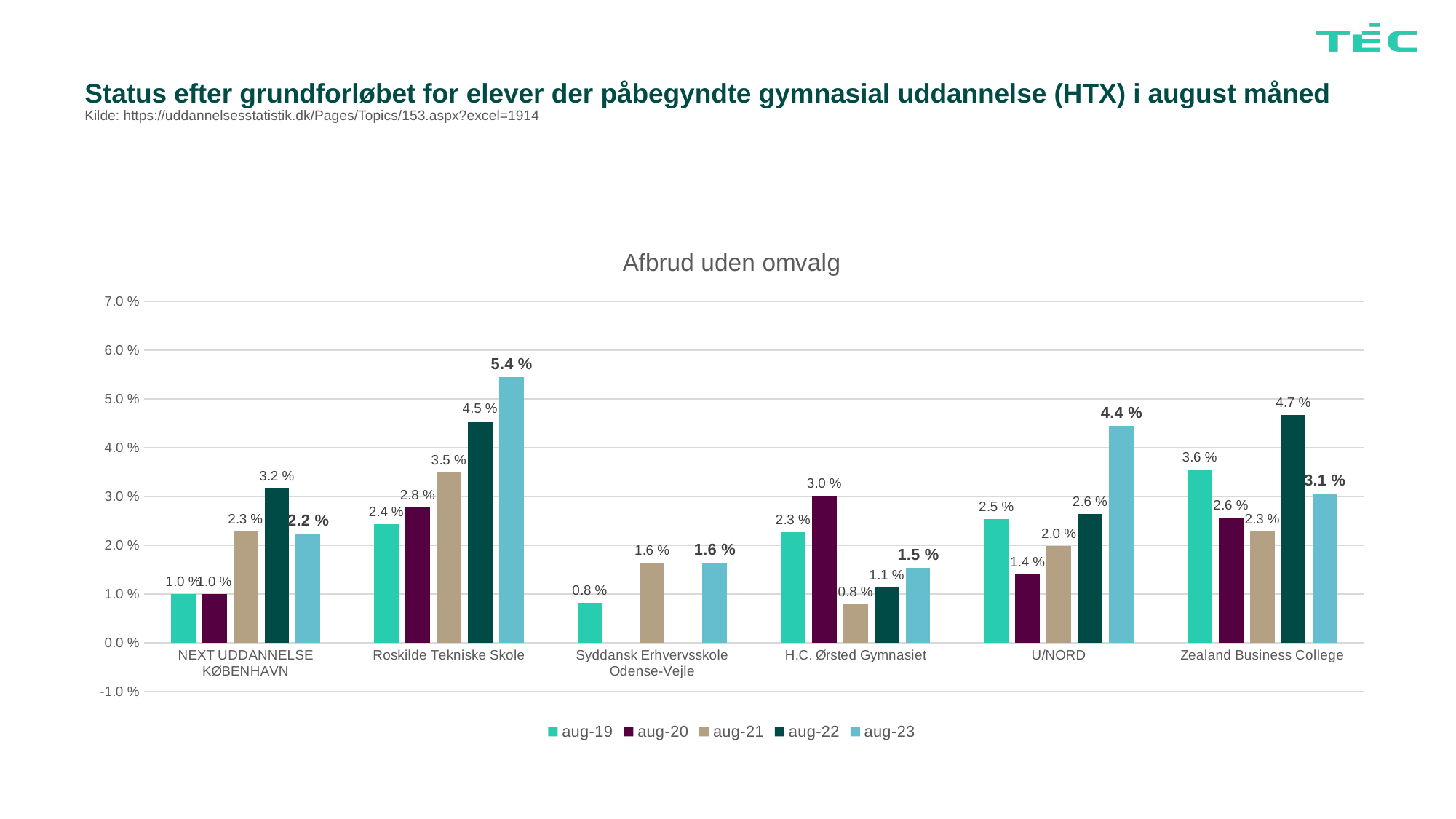
Which is larger for Zealand Business College: the aug-19 value or the aug-20 value? aug-19 Which school has the lowest aug-19 value? Syddansk Erhvervsskole Odense-Vejle What is the aug-20 value for H.C. Ørsted Gymnasiet? 3.0 % What is the aug-22 value for Zealand Business College? 4.7 % How many series does the legend list? 5 Which school has the highest aug-23 value? Roskilde Tekniske Skole What is the difference between the aug-23 and aug-19 values for U/NORD? 1.9 % Do the values for Roskilde Tekniske Skole rise or fall from aug-19 to aug-23? Rise What kind of chart is shown? Bar chart What is the aug-21 value for U/NORD? 2.0 % What is the aug-23 value for Roskilde Tekniske Skole? 5.4 % How many schools are shown on the x axis? 6